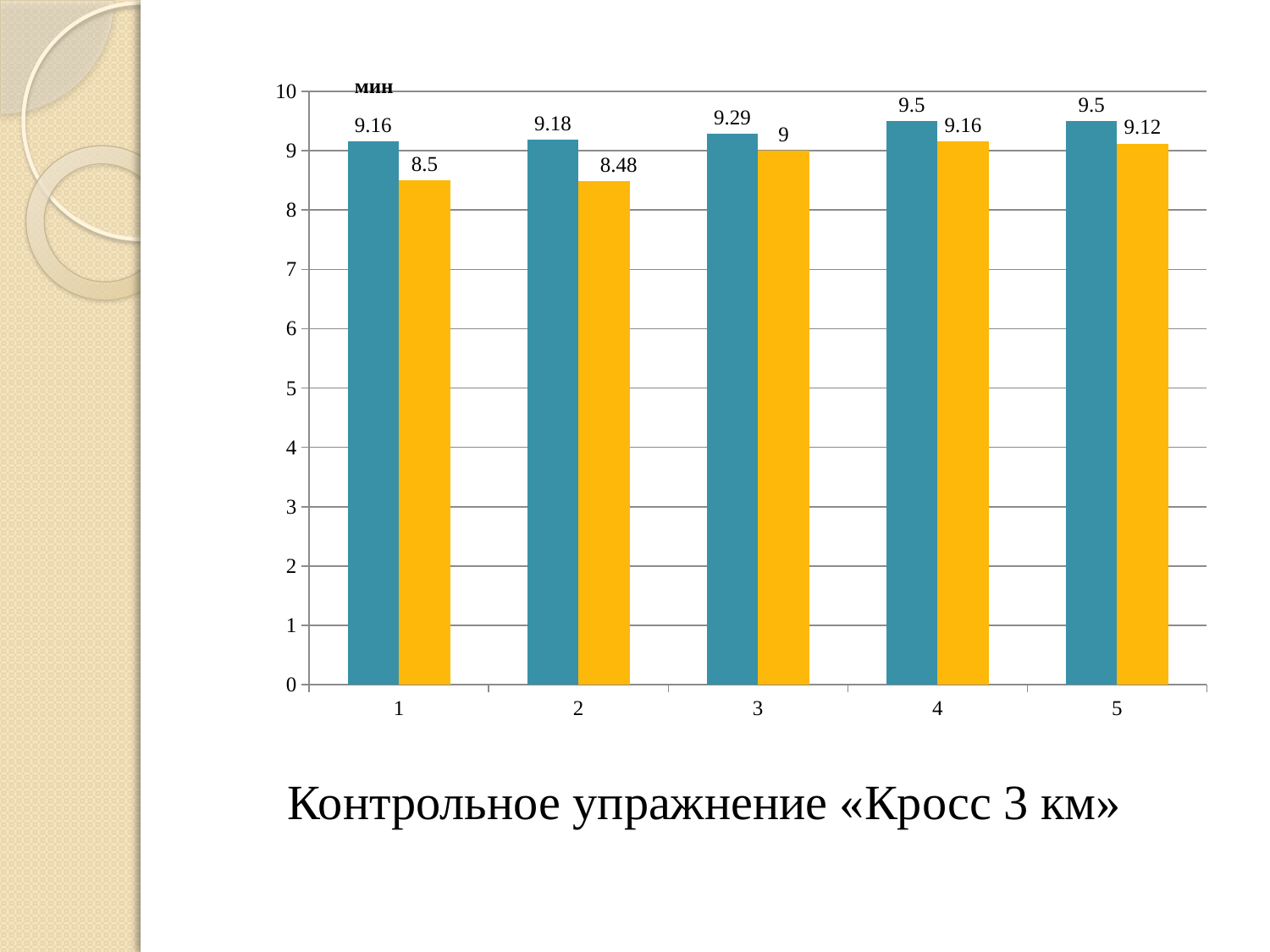
What is the value of the orange bar for category 3? 9 How many categories are shown on the x axis? 5 What is the value of the blue bar for category 1? 9.16 What kind of chart is shown on the slide? bar chart What unit is written at the top of the vertical axis? мин What is the value of the blue bar for category 5? 9.5 What is the value of the orange bar for category 2? 8.48 What is the difference between the blue and orange bars for category 1? 0.66 For which category is the orange bar the lowest? 2 For which category is the orange bar the highest? 4 Which is larger for category 3: the blue bar or the orange bar? the blue bar What is the difference between the blue and orange bars for category 5? 0.38